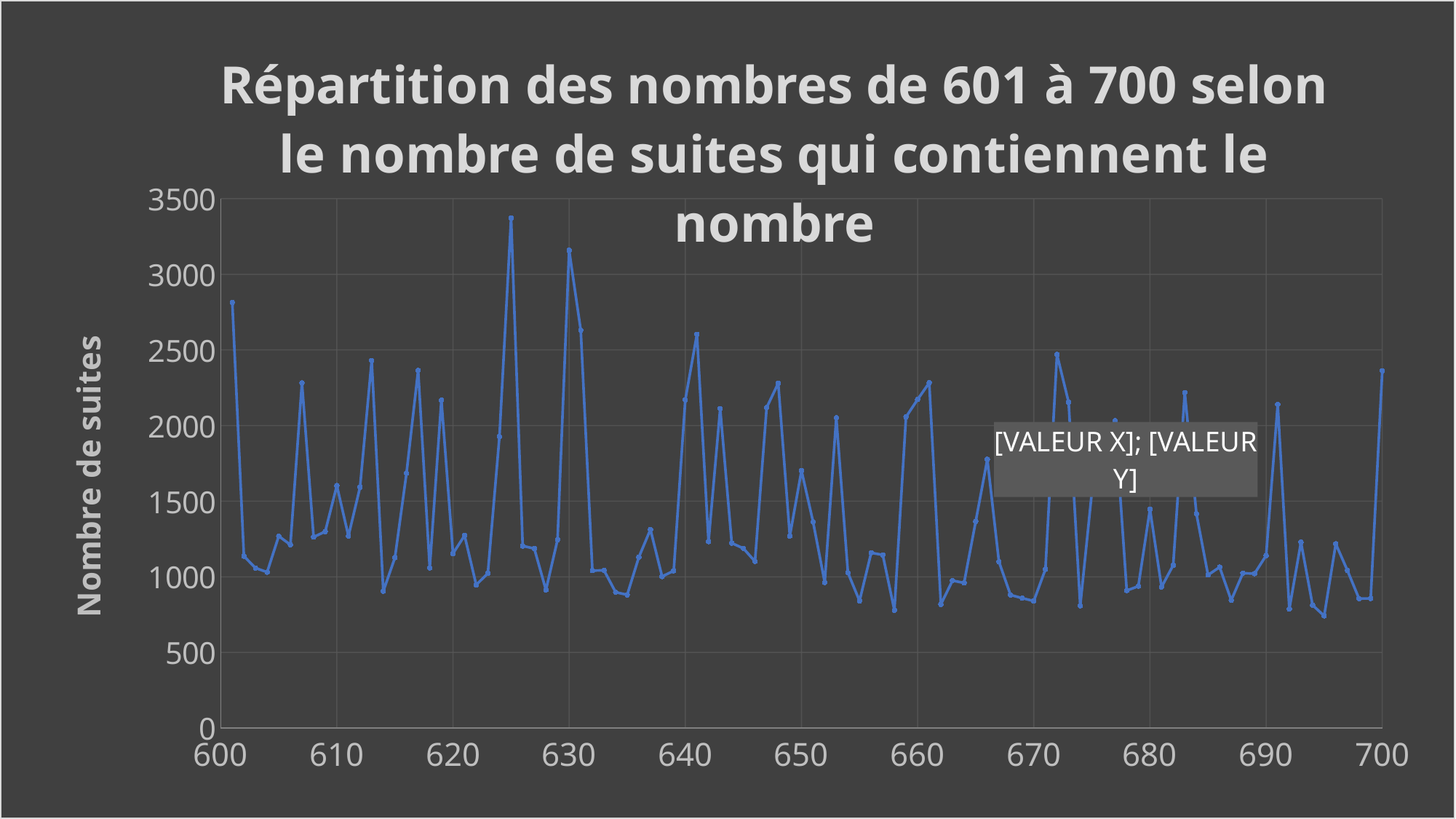
Which has the larger value, x = 625 or x = 630? 625 Is the value at x = 601 greater or less than 2500? greater Is the value at x = 630 greater or less than 3000? greater What is the title of the chart? Répartition des nombres de 601 à 700 selon le nombre de suites qui contiennent le nombre Which has the larger value, x = 601 or x = 613? 601 Is the value at x = 604 greater or less than 1500? less What is the label of the vertical axis? Nombre de suites At which x value does the line reach its highest point? 625 What kind of chart is shown on the slide? line chart